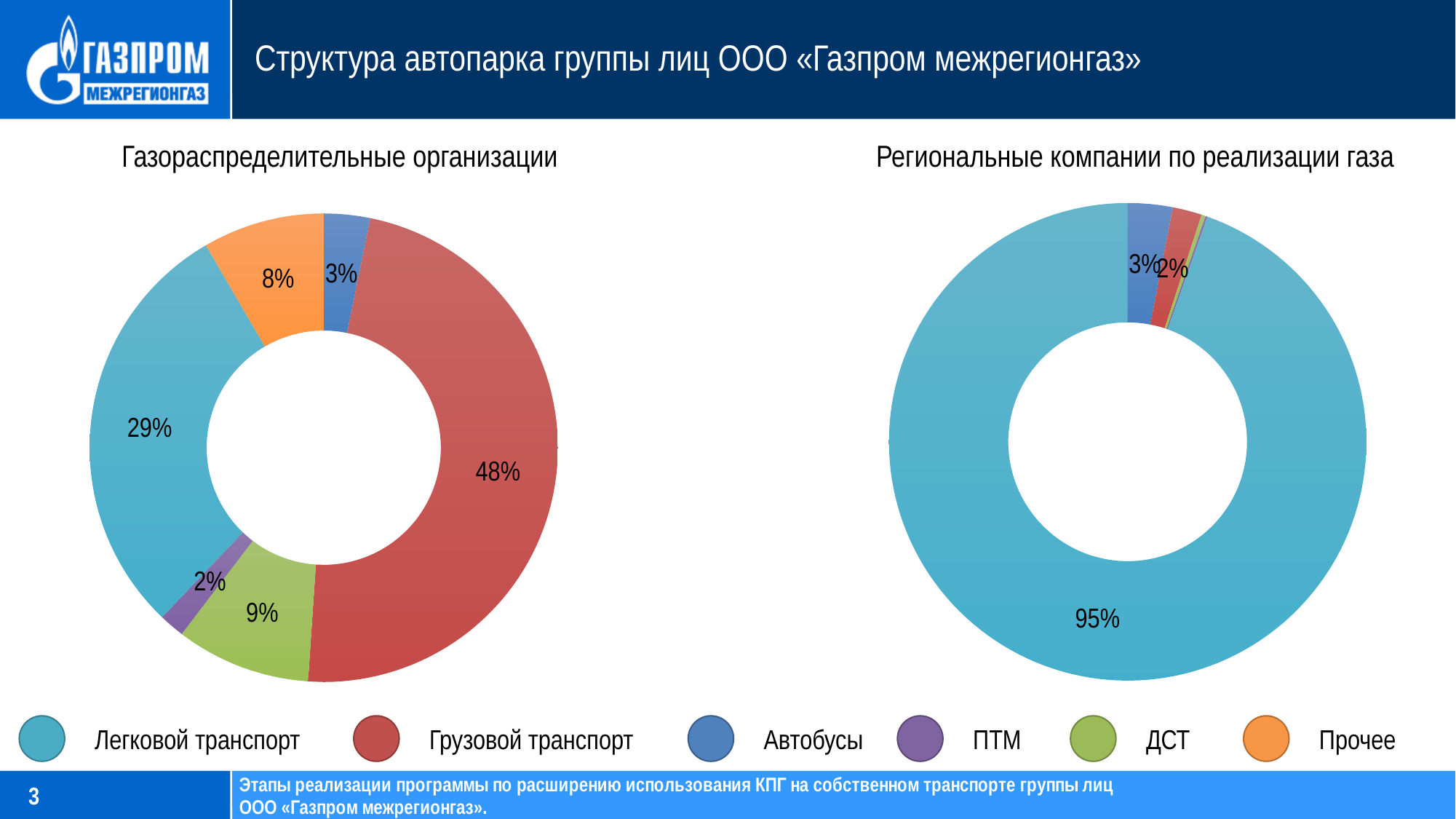
In the chart titled «Газораспределительные организации», what share is ДСТ? 9% In the chart titled «Газораспределительные организации», what share is Грузовой транспорт? 48% In the chart titled «Региональные компании по реализации газа», what share is Легковой транспорт? 95% In the chart titled «Газораспределительные организации», which category has the smallest share? ПТМ How many categories does the shared legend list? 6 In the chart titled «Газораспределительные организации», what share is Легковой транспорт? 29% In the chart titled «Газораспределительные организации», which is larger: ДСТ or Прочее? ДСТ In the chart titled «Газораспределительные организации», which category has the largest share? Грузовой транспорт What type of chart is used on this slide? Doughnut (pie) chart Which colour represents Автобусы in the legend? Blue In the chart titled «Газораспределительные организации», what is the difference in percentage points between Грузовой транспорт and Легковой транспорт? 19 In the chart titled «Региональные компании по реализации газа», what share is Автобусы? 3%